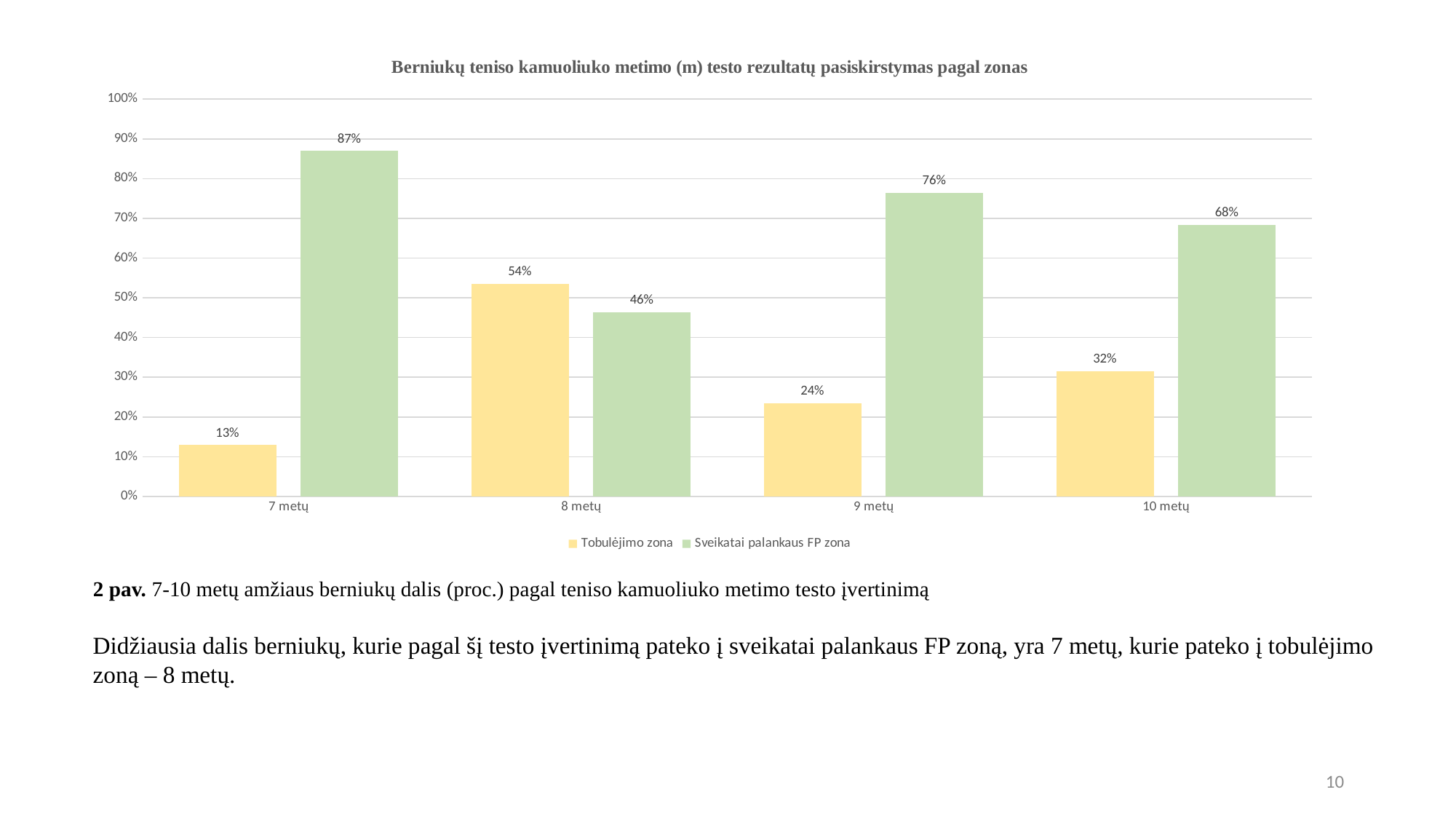
Which is larger at 10 metų: Tobulėjimo zona or Sveikatai palankaus FP zona? Sveikatai palankaus FP zona What is the value for Tobulėjimo zona at 10 metų? 32% What is the value for Sveikatai palankaus FP zona at 9 metų? 76% How many series does the legend list? 2 Which age group has the highest value for Tobulėjimo zona? 8 metų What colour are the Sveikatai palankaus FP zona bars? Green Which age group has the highest value for Sveikatai palankaus FP zona? 7 metų How many age groups are shown on the x axis? 4 Which age group has the lowest value for Tobulėjimo zona? 7 metų What is the difference between Sveikatai palankaus FP zona and Tobulėjimo zona at 8 metų? 8% What is the value for Tobulėjimo zona at 7 metų? 13% What kind of chart is shown on the slide? Bar chart